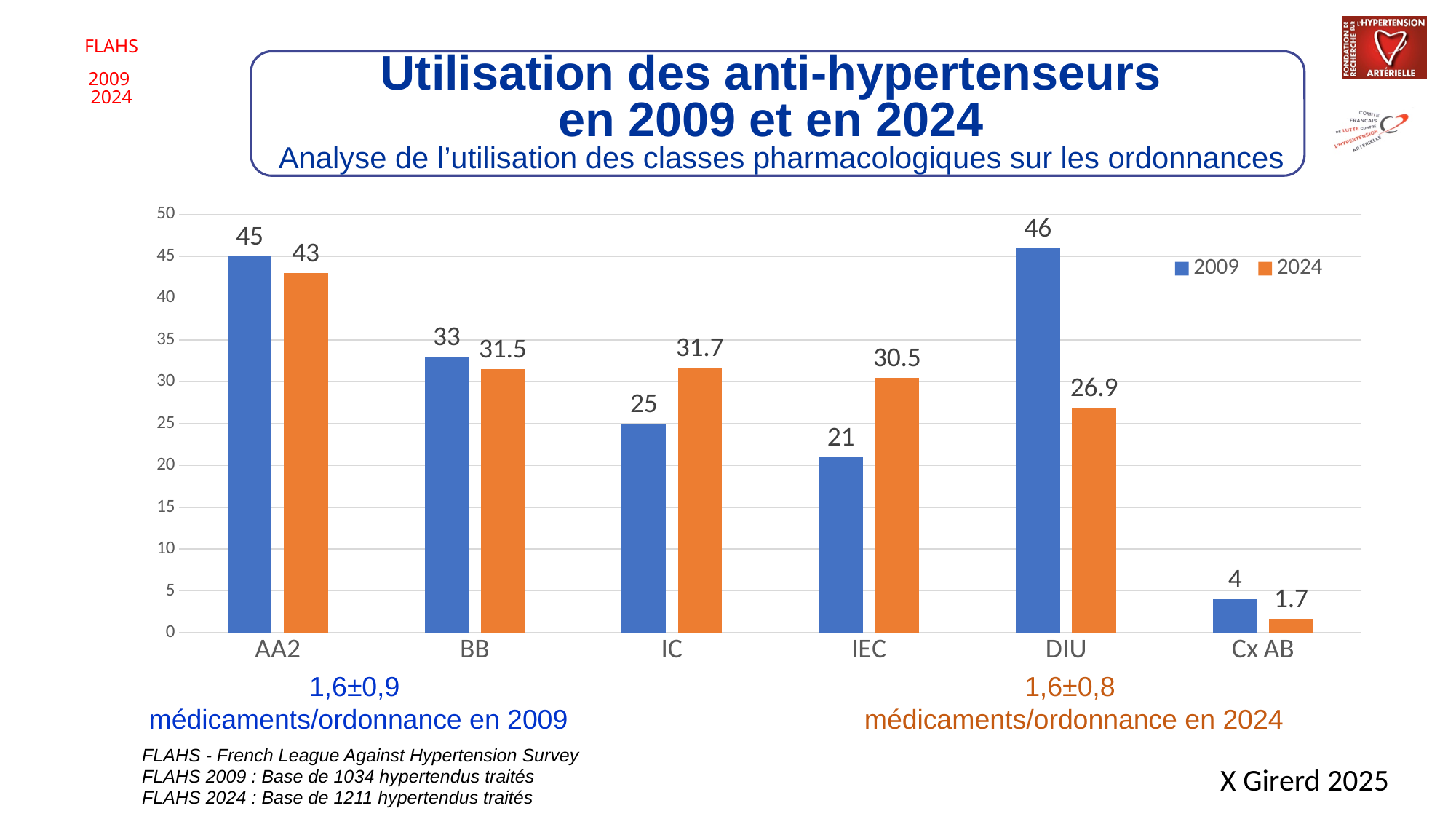
What is the value for AA2 in the 2009 series? 45 What is the value for DIU in the 2024 series? 26.9 Which is larger for IEC: the 2009 value or the 2024 value? 2024 Which colour represents the 2024 series in the legend? Orange What is the difference between the 2009 and 2024 values for DIU? 19.1 Which category has the lowest value in the 2024 series? Cx AB What kind of chart is shown on the slide? Bar chart What is the difference between the 2009 and 2024 values for BB? 1.5 How many categories are shown on the x axis? 6 What is the value for IC in the 2024 series? 31.7 Which category has the highest value in the 2009 series? DIU How many series does the legend list? 2